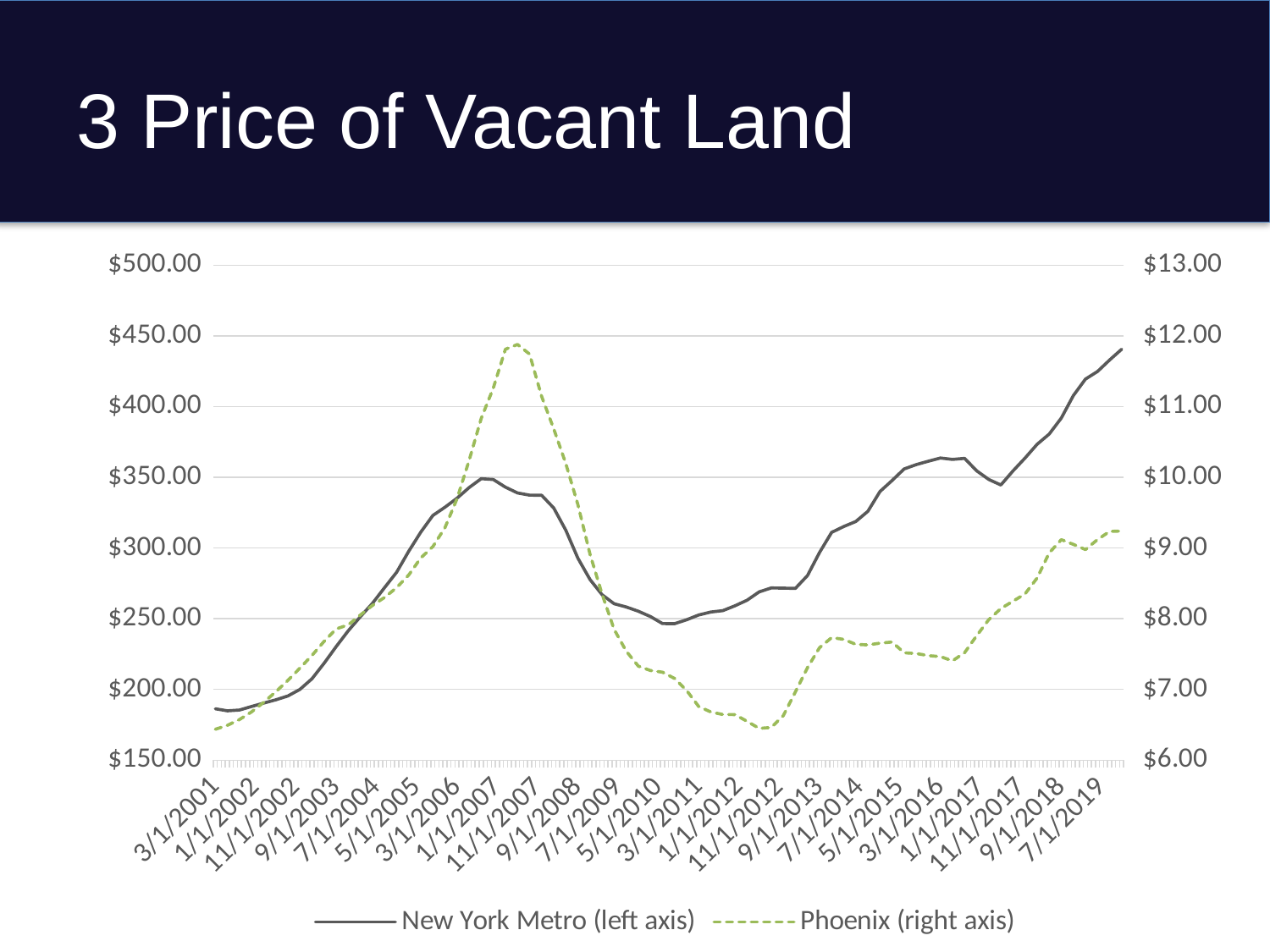
How many series does the legend list? 2 Is the value for Phoenix at 11/1/2012 greater or less than $7.00? less Is the value for Phoenix at 7/1/2019 greater or less than $8.00? greater What kind of chart is shown on the slide? line chart Does the Phoenix line rise or fall between 1/1/2007 and 11/1/2012? fall Which series is plotted against the right axis? Phoenix Is the value for New York Metro at 3/1/2001 greater or less than $200.00? less What is the highest value shown on the left axis? $500.00 Does the New York Metro line rise or fall between 3/1/2001 and 1/1/2007? rise